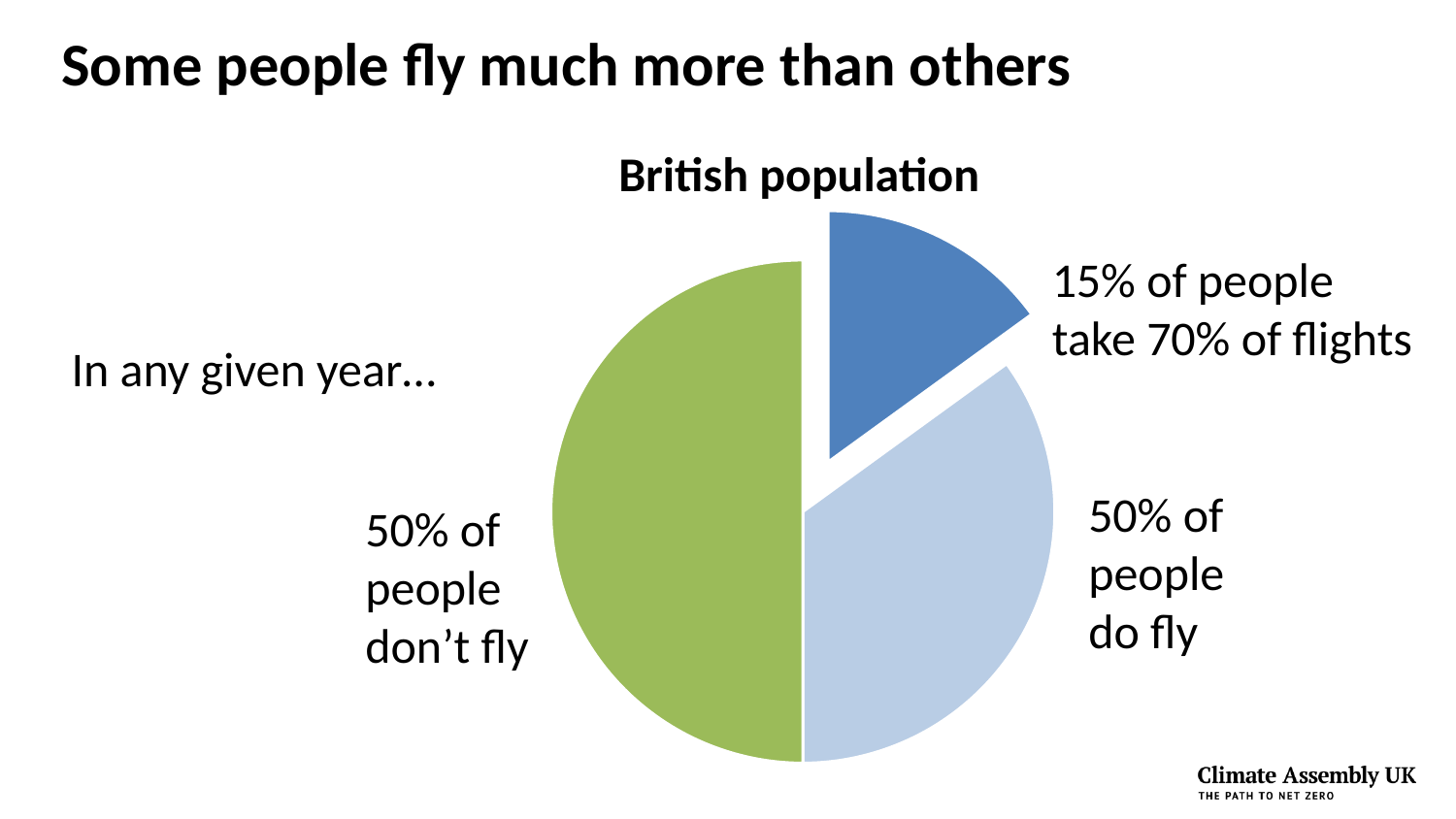
According to the pie chart, what share of people do fly in any given year? 50% Which slice of the pie chart is the smallest? 15% of people take 70% of flights What colour is the slice representing the 50% of people who don't fly? Green According to the pie chart, what share of people don't fly in any given year? 50% What kind of chart is shown on the slide? Pie chart What is the title of the pie chart? British population What share of people take 70% of flights, according to the chart? 15% Which slice of the pie chart is the largest? 50% of people don't fly Which is larger: the share of people who don't fly or the share of people who take 70% of flights? The share of people who don't fly How many slices does the pie chart have? 3 What share of flights is taken by 15% of people, according to the chart? 70% What is the difference in percentage points between the share of people who don't fly (50%) and the share of people who take 70% of flights (15%)? 35 percentage points